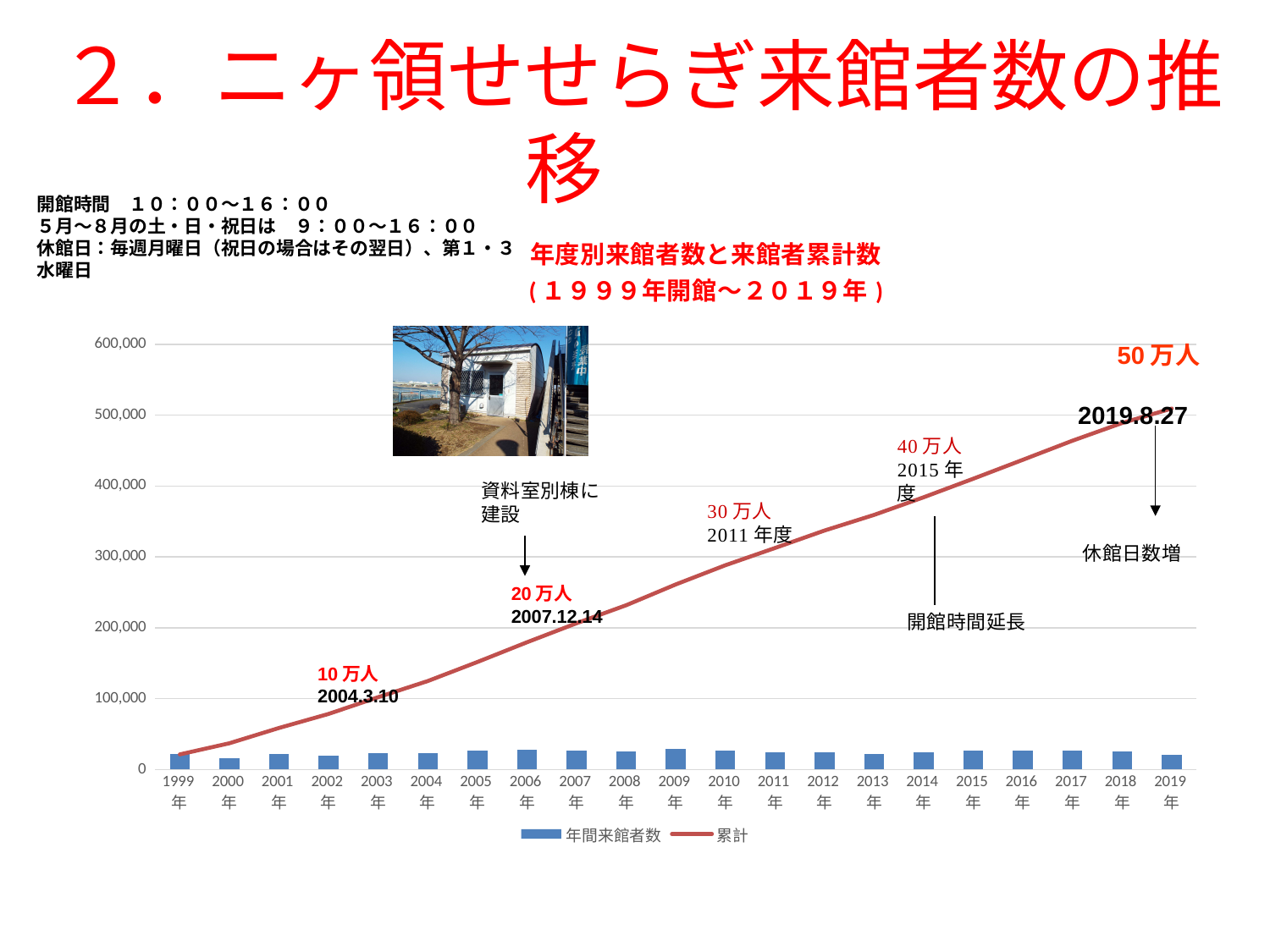
How many series does the chart legend list? 2 Is the 累計 value for 2005年 greater or less than 100,000? greater What kind of chart is shown on the slide? A combined bar and line chart Is the 累計 value for 2009年 greater or less than 300,000? less What are the two series named in the chart legend? 年間来館者数 and 累計 Is the 累計 value for 2017年 greater or less than 400,000? greater How many years are shown along the x axis of the chart? 21 What is the first year shown on the x axis of the chart? 1999年 Does the 累計 (cumulative) line rise or fall from 1999 to 2019? rise